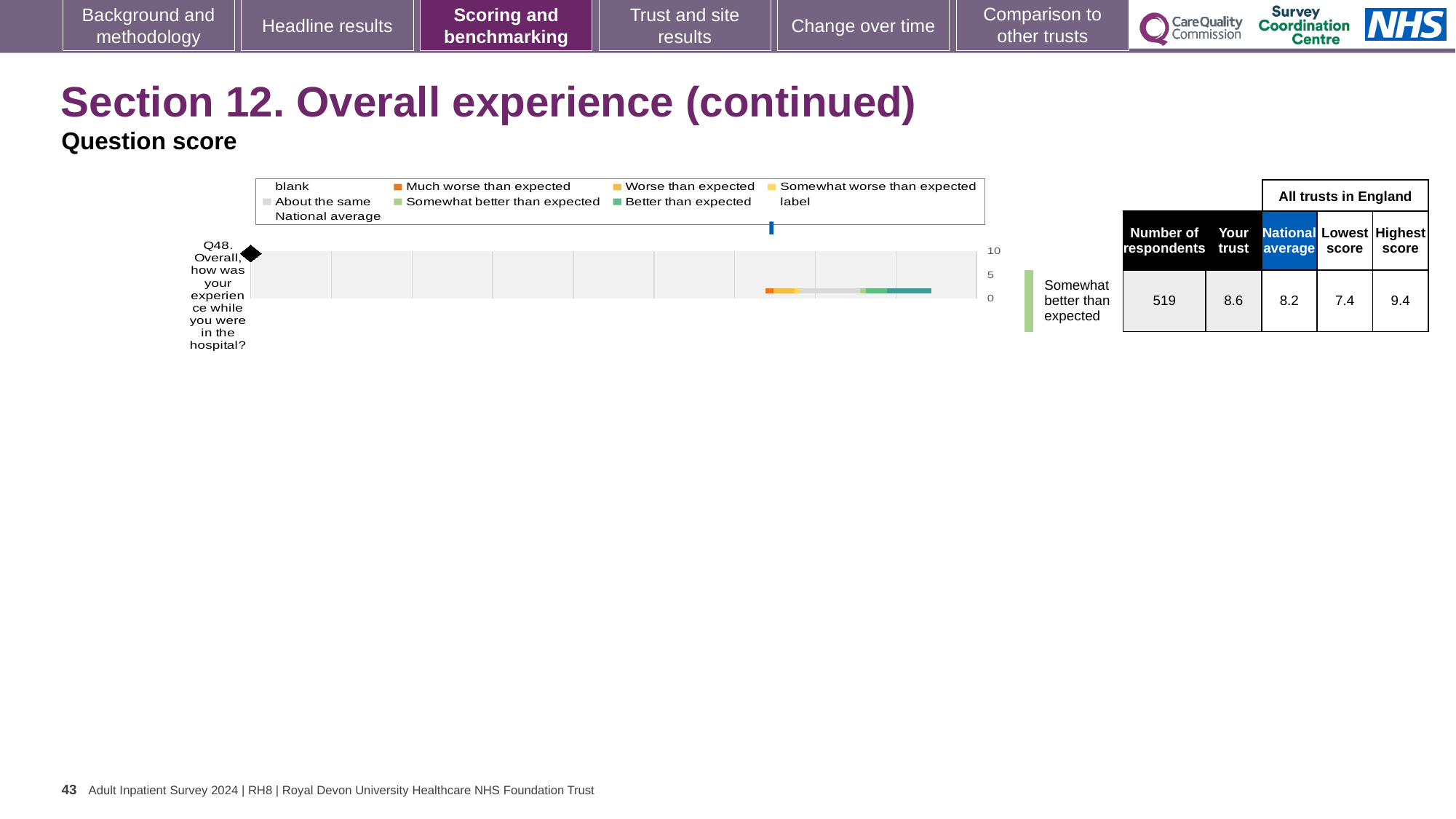
What is the difference between the highest and lowest scores for Q48 across all trusts in England? 2.0 What is the highest score among all trusts in England for Q48? 9.4 Is the trust's score for Q48 greater or less than 5 on the chart's axis? greater How many respondents answered Q48? 519 What is the national average score for Q48? 8.2 By how much does the trust's score for Q48 exceed the national average? 0.4 What is the 'Your trust' score for Q48, 'Overall, how was your experience while you were in the hospital?' 8.6 What is the lowest score among all trusts in England for Q48? 7.4 How many questions (categories) are plotted in the chart? 1 Which is higher for Q48: the trust's score or the national average? Your trust Which benchmarking category is the trust's Q48 result placed in? Somewhat better than expected What kind of chart is shown for Q48 on the slide? bar chart